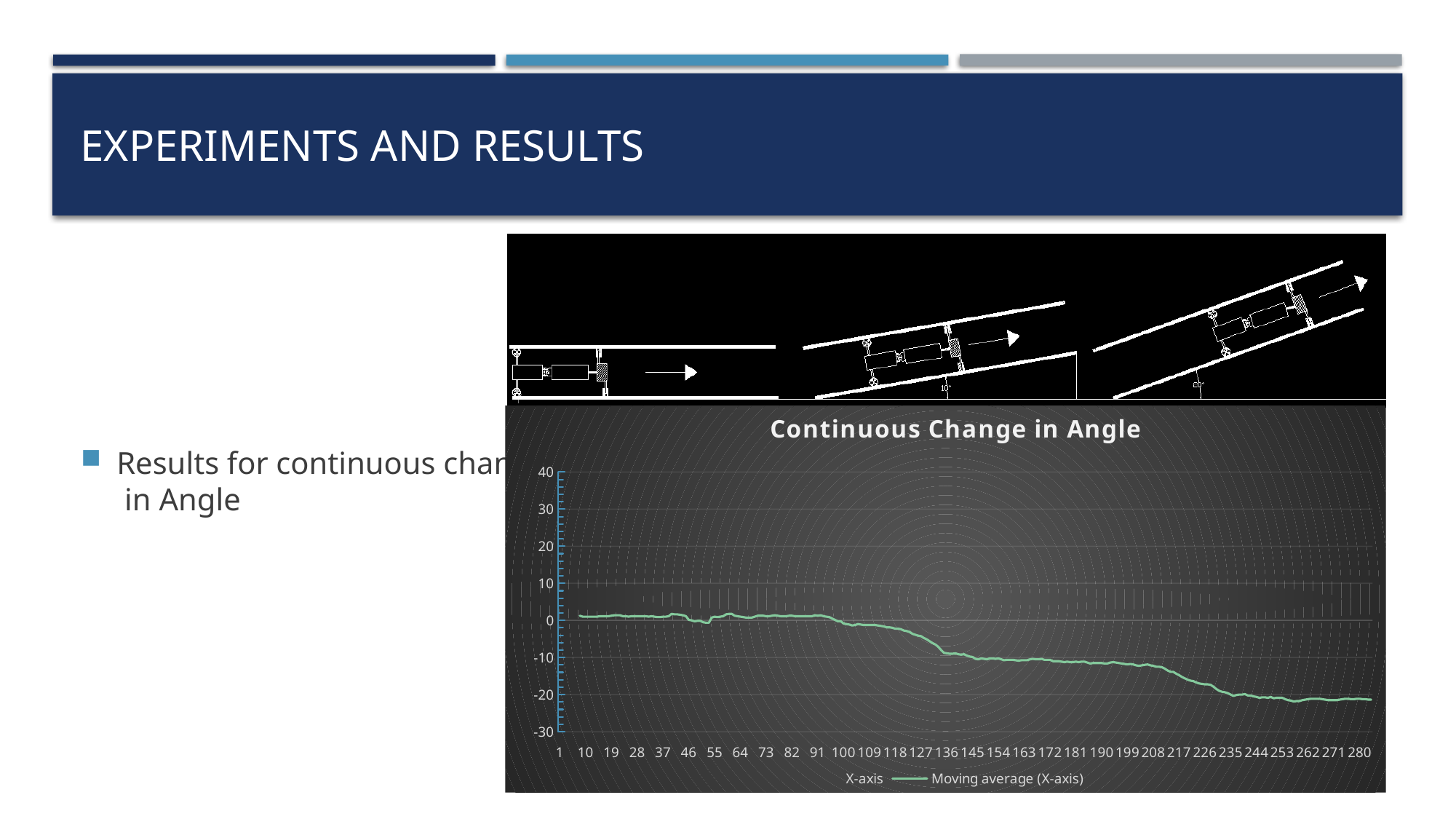
What kind of chart is shown under the title "Continuous Change in Angle"? Line chart In the "Continuous Change in Angle" chart, does the plotted line generally rise or fall as the x axis increases? Fall In the "Continuous Change in Angle" chart, is the value at x = 280 greater or less than -10? less In the "Continuous Change in Angle" chart, is the value at x = 280 greater or less than -30? greater What are the two legend entries in the "Continuous Change in Angle" chart? X-axis; Moving average (X-axis) In the "Continuous Change in Angle" chart, is the value at x = 190 greater or less than 0? less What is the highest tick label on the y axis of the "Continuous Change in Angle" chart? 40 In the "Continuous Change in Angle" chart, which is larger: the value at x = 1 or the value at x = 280? x = 1 What is the title of the chart on the slide? Continuous Change in Angle How many series does the legend of the "Continuous Change in Angle" chart list? 2